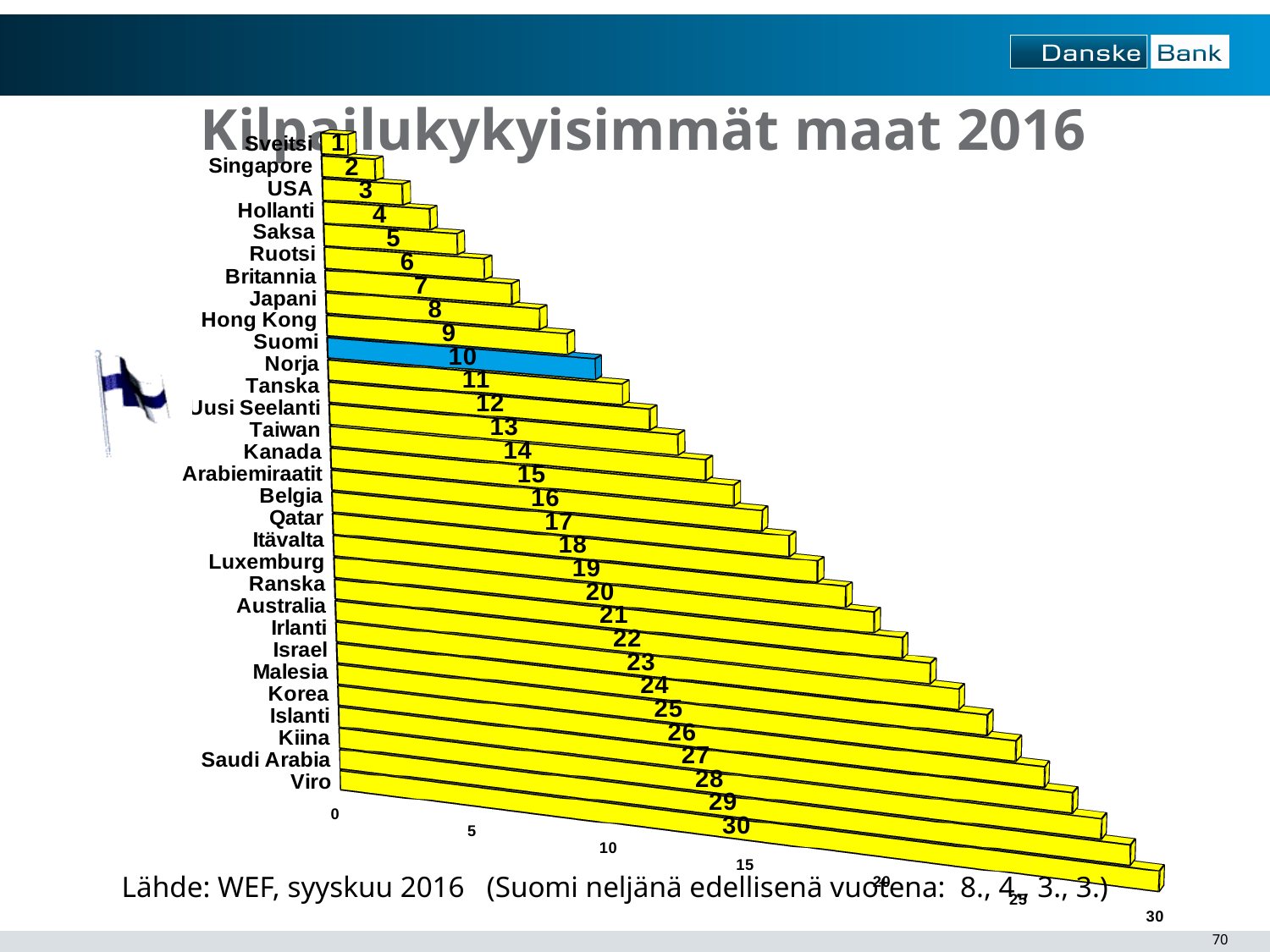
Do the values rise or fall going down the list of countries from Sveitsi to Viro? rise Which category has the highest value in the chart? Viro How many categories (countries) are plotted in the chart? 30 What is the value shown for Suomi? 10 What kind of chart is shown on the slide? bar chart What is the value shown for Viro? 30 Which category has the lowest value in the chart? Sveitsi What is the difference between the values for Viro and Suomi? 20 What is the value shown for Sveitsi? 1 What is the title of the chart? Kilpailukykyisimmät maat 2016 What is the value shown for Kanada? 15 Which has the larger value, Norja or Japani? Norja